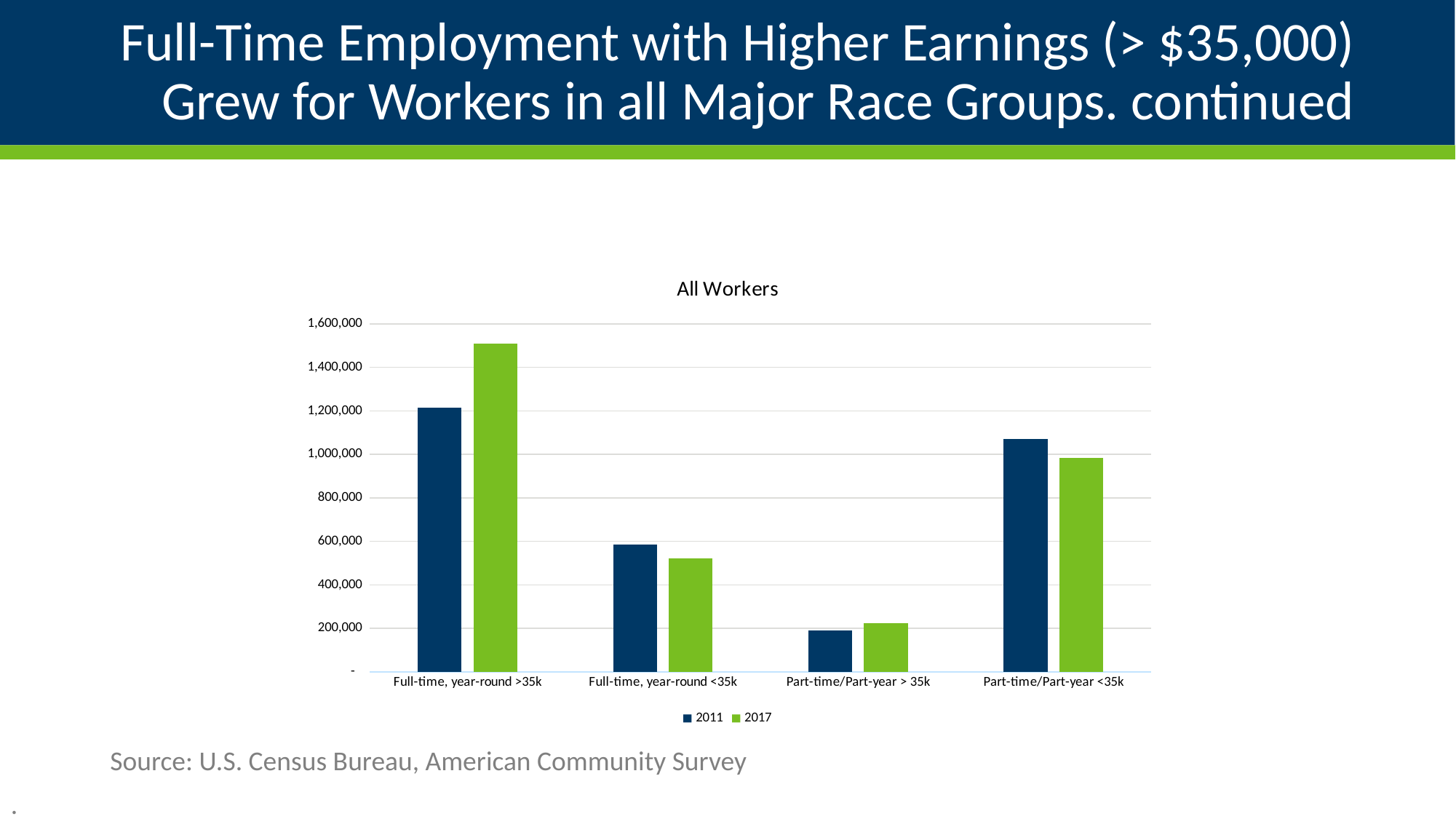
How many categories are shown on the x axis? 4 Is the 2011 value for Part-time/Part-year <35k greater or less than 1,000,000? greater How many series does the legend list? 2 Which category has the highest 2017 value? Full-time, year-round >35k For Full-time, year-round >35k, which is larger: the 2011 value or the 2017 value? 2017 For Part-time/Part-year <35k, which is larger: the 2011 value or the 2017 value? 2011 What is the title of the chart? All Workers Is the 2017 value for Full-time, year-round >35k greater or less than 1,400,000? greater What kind of chart is shown on the slide? bar chart Is the 2017 value for Full-time, year-round <35k greater or less than 600,000? less Which category has the lowest 2011 value? Part-time/Part-year > 35k